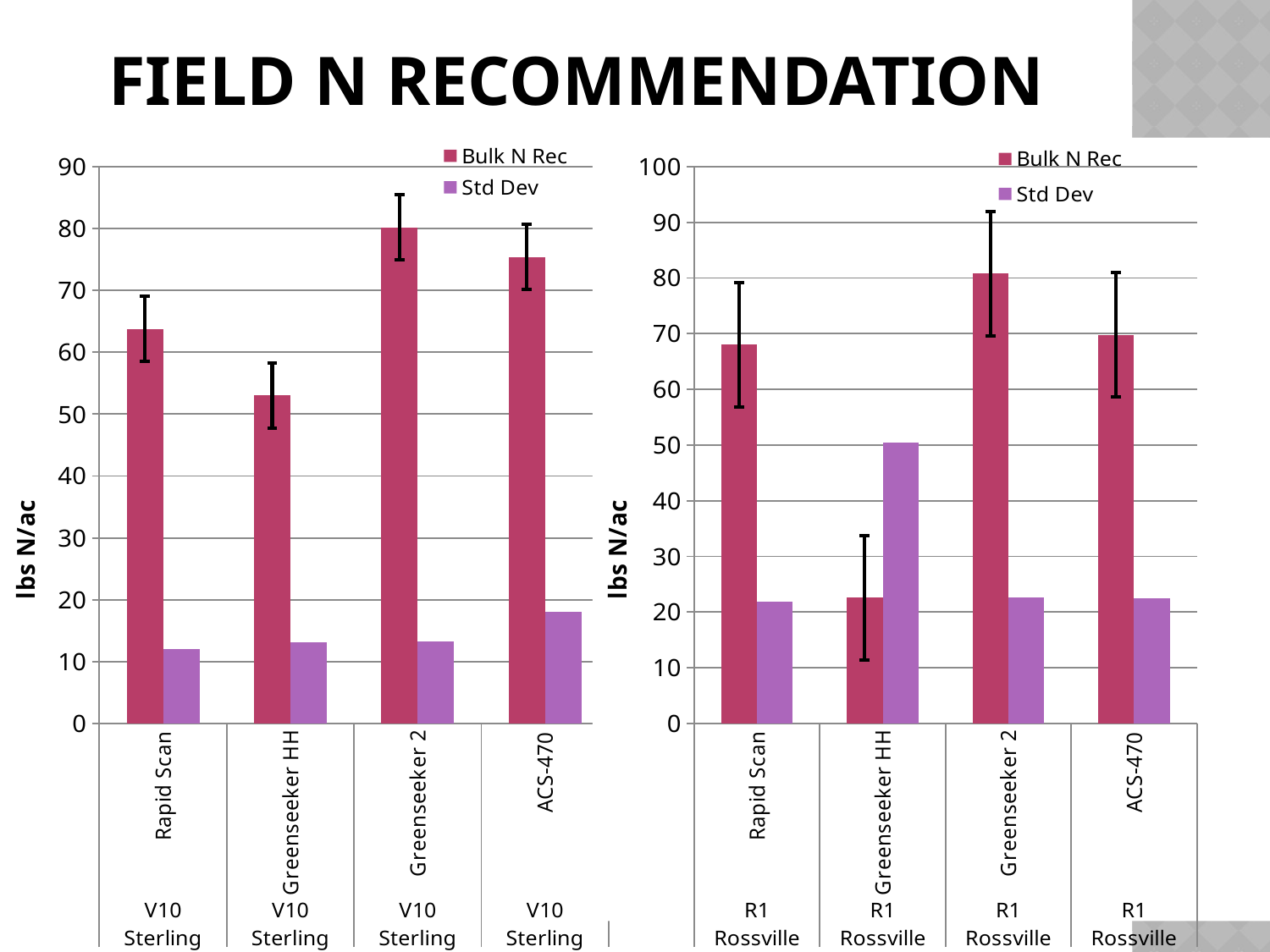
In the left chart (V10 Sterling), which sensor has the lowest Bulk N Rec? Greenseeker HH What kind of chart is the left chart (V10 Sterling)? bar chart How many series does the legend of the left chart (V10 Sterling) list? 2 In the left chart (V10 Sterling), which sensor has the highest Bulk N Rec? Greenseeker 2 In the right chart (R1 Rossville), is the Bulk N Rec value for Greenseeker 2 greater or less than 70? greater In the left chart (V10 Sterling), is the Bulk N Rec value for Greenseeker HH greater or less than 60? less In the right chart (R1 Rossville), which sensor has the lowest Bulk N Rec? Greenseeker HH What is the y-axis title of the left chart (V10 Sterling)? lbs N/ac In the left chart (V10 Sterling), is the Std Dev value for ACS-470 greater or less than 20? less In the right chart (R1 Rossville), which has the larger Bulk N Rec: Rapid Scan or Greenseeker HH? Rapid Scan In the right chart (R1 Rossville), which sensor has the highest Std Dev? Greenseeker HH How many sensor categories are shown in the right chart (R1 Rossville)? 4